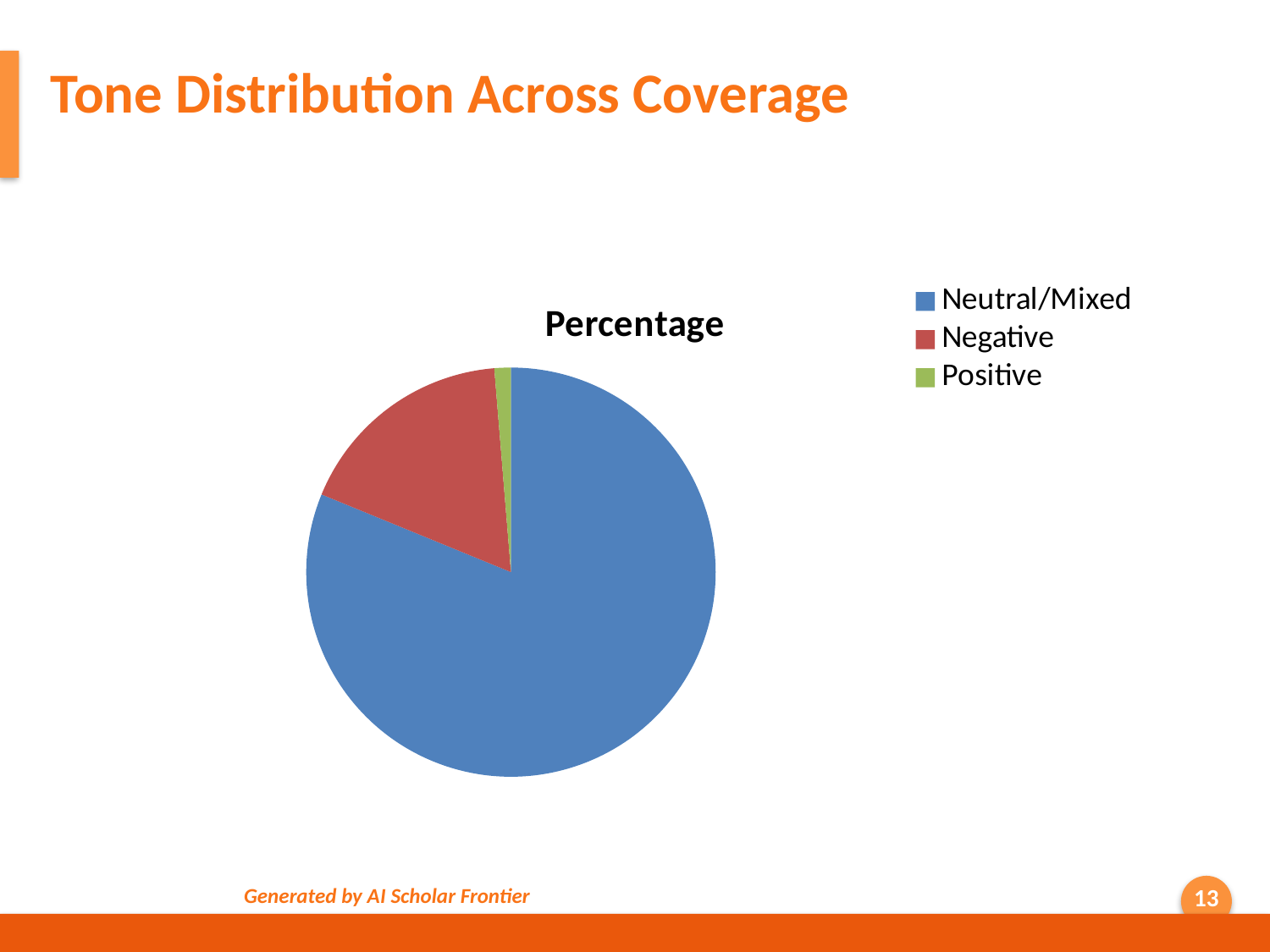
Which category has the smallest slice of the pie? Positive What kind of chart is shown on the slide? pie chart Which colour represents the Negative category in the pie chart? red How many slices does the pie chart have? 3 How many entries does the legend list? 3 Which slice is larger, Neutral/Mixed or Negative? Neutral/Mixed Which slice is larger, Negative or Positive? Negative Which category has the largest slice of the pie? Neutral/Mixed What is the title of the chart? Percentage Does the Neutral/Mixed slice take up more or less than half of the pie? more